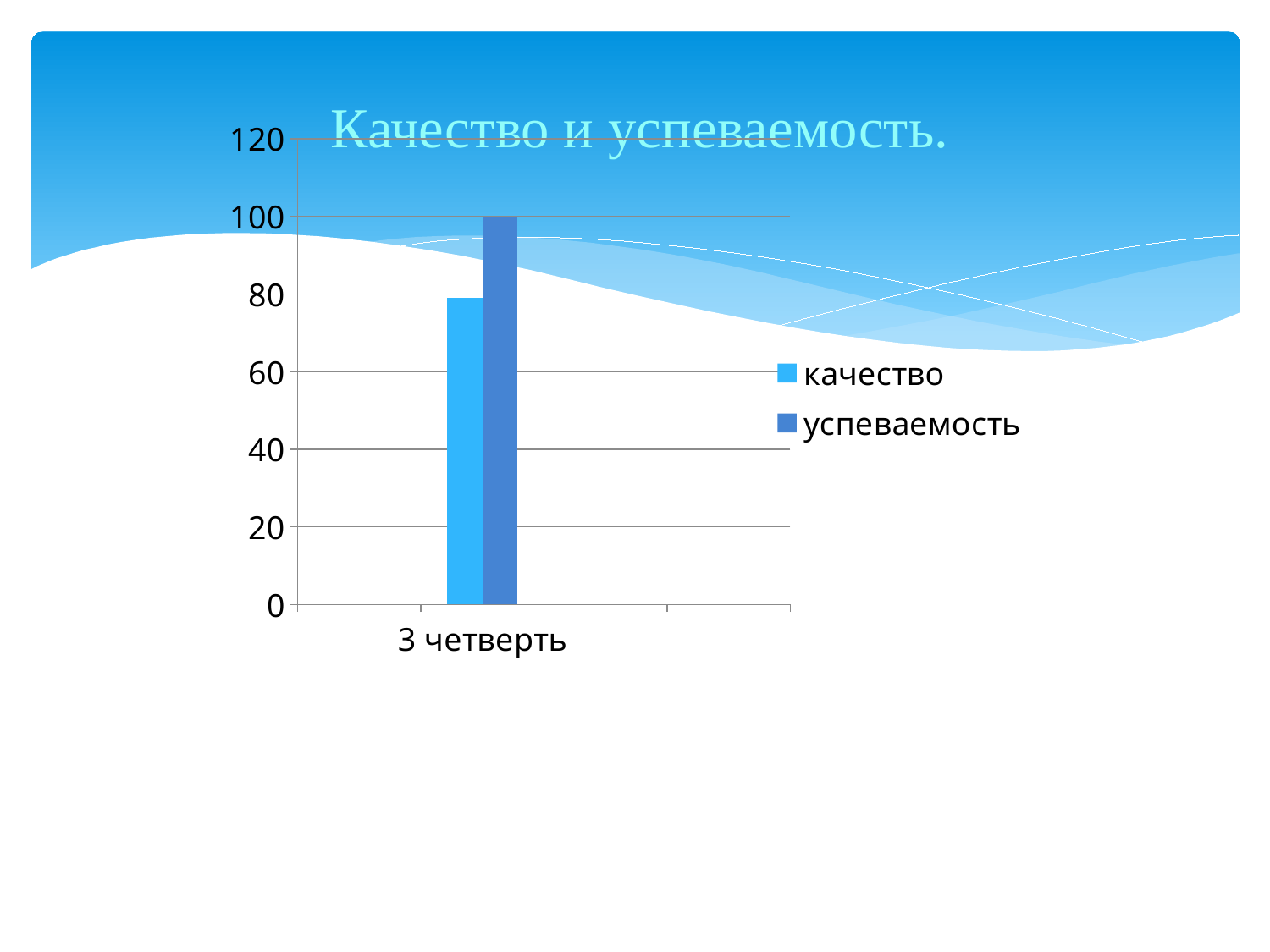
What is the title of the chart? Качество и успеваемость. How many series does the legend list? 2 What kind of chart is shown on the slide? bar chart Which series has the taller bar for 3 четверть, качество or успеваемость? успеваемость How many categories are shown on the x axis? 1 Is the value for качество in 3 четверть greater or less than 60? greater What is the category label on the x axis? 3 четверть Is the value for успеваемость in 3 четверть greater or less than 80? greater Is the value for качество in 3 четверть greater or less than 100? less What is the value for успеваемость in 3 четверть? 100 Which series has the lowest value for 3 четверть? качество